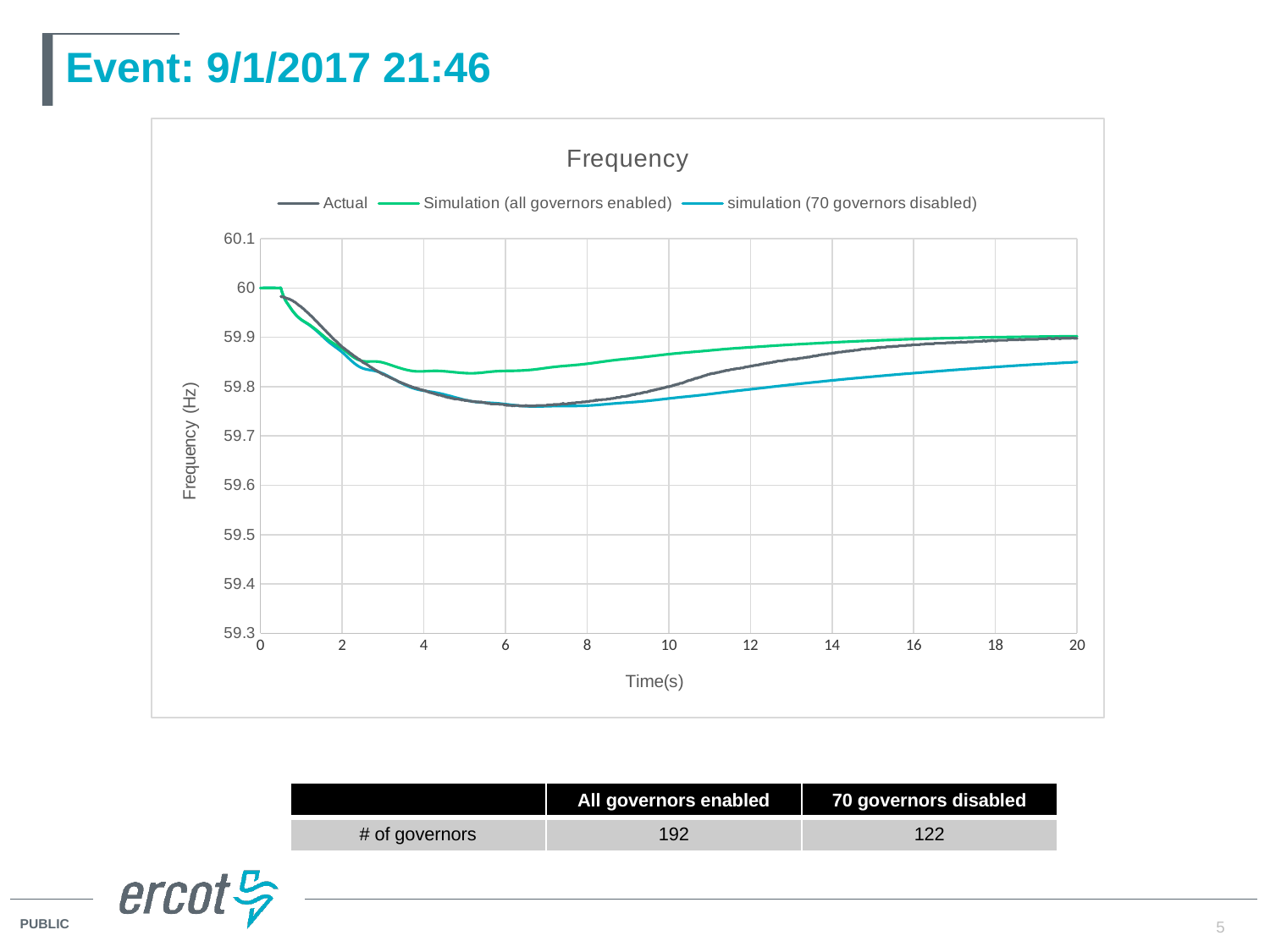
Between 0 and 6 seconds, does the Actual frequency rise or fall? fall Which series has the highest minimum frequency over the 20 seconds? Simulation (all governors enabled) At 10 seconds, which series is higher: Simulation (all governors enabled) or simulation (70 governors disabled)? Simulation (all governors enabled) At 16 seconds, which series is higher: Actual or simulation (70 governors disabled)? Actual How many series does the legend of the Frequency chart list? 3 Is the value of the Simulation (all governors enabled) series at 6 seconds greater or less than 59.8? greater What kind of chart is shown on the slide? line chart Is the value of the simulation (70 governors disabled) series at 6 seconds greater or less than 59.8? less Is the lowest value reached by the Actual series greater or less than 59.7? greater What is the title of the chart? Frequency What is the label of the y axis of the chart? Frequency (Hz)